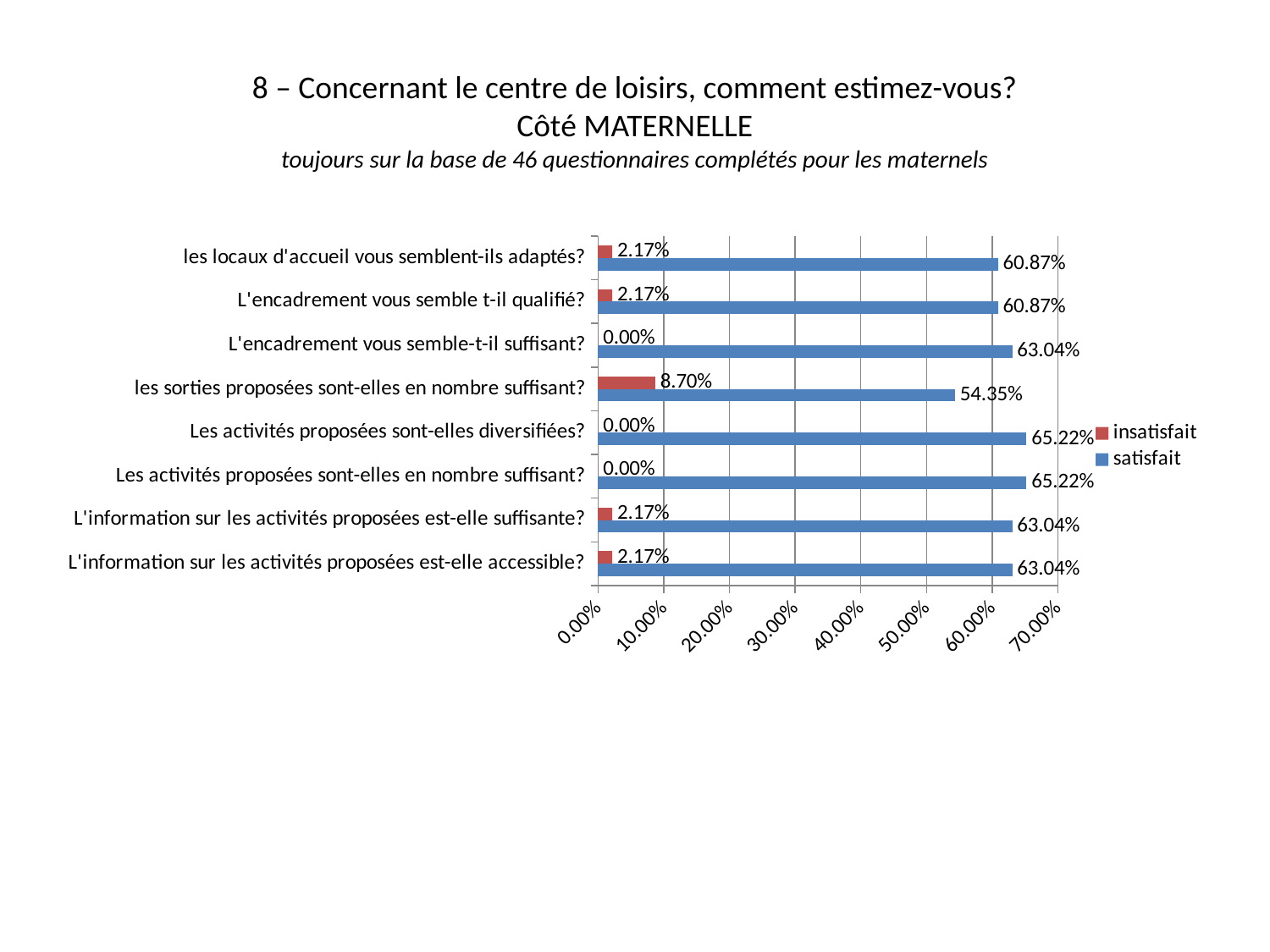
Which category has the lowest 'satisfait' value? les sorties proposées sont-elles en nombre suffisant? How many series does the legend list? 2 What kind of chart is shown on the slide? bar chart How many categories are shown on the chart? 8 What is the 'insatisfait' value for 'les sorties proposées sont-elles en nombre suffisant?' 8.70% What is the 'satisfait' value for 'L'encadrement vous semble-t-il suffisant?' 63.04% What is the difference between the 'satisfait' values for 'Les activités proposées sont-elles diversifiées?' and 'les sorties proposées sont-elles en nombre suffisant?' 10.87% Which is larger: the 'satisfait' value for 'L'encadrement vous semble t-il qualifié?' or for 'Les activités proposées sont-elles en nombre suffisant?' Les activités proposées sont-elles en nombre suffisant? Which category has the highest 'insatisfait' value? les sorties proposées sont-elles en nombre suffisant? What is the 'satisfait' value for 'les sorties proposées sont-elles en nombre suffisant?' 54.35% What is the 'insatisfait' value for 'les locaux d'accueil vous semblent-ils adaptés?' 2.17% Which series is shown in blue? satisfait